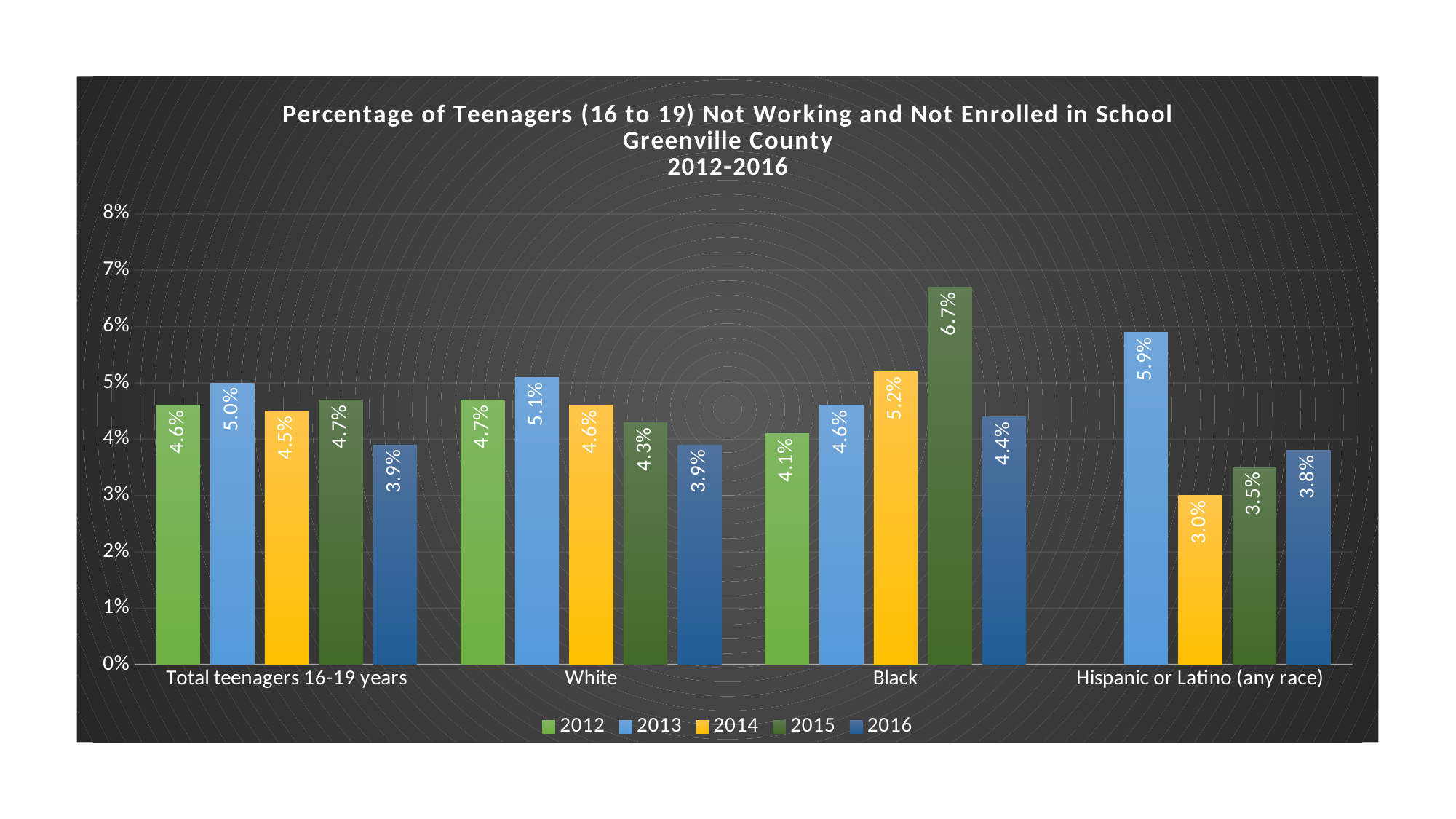
Which category has the highest 2015 value? Black How many categories are shown on the x axis? 4 Which is larger, the 2013 value for White or the 2013 value for Black? White What is the difference between the 2015 value for Black and the 2015 value for White? 2.4% What is the 2016 value for Total teenagers 16-19 years? 3.9% Which category has the lowest 2014 value? Hispanic or Latino (any race) What is the 2015 value for Black? 6.7% How many series does the legend list? 5 What type of chart is shown on the slide? bar chart Do the values for Hispanic or Latino (any race) rise or fall from 2014 to 2016? rise What is the 2013 value for Hispanic or Latino (any race)? 5.9% Which year's series is missing a bar for Hispanic or Latino (any race)? 2012